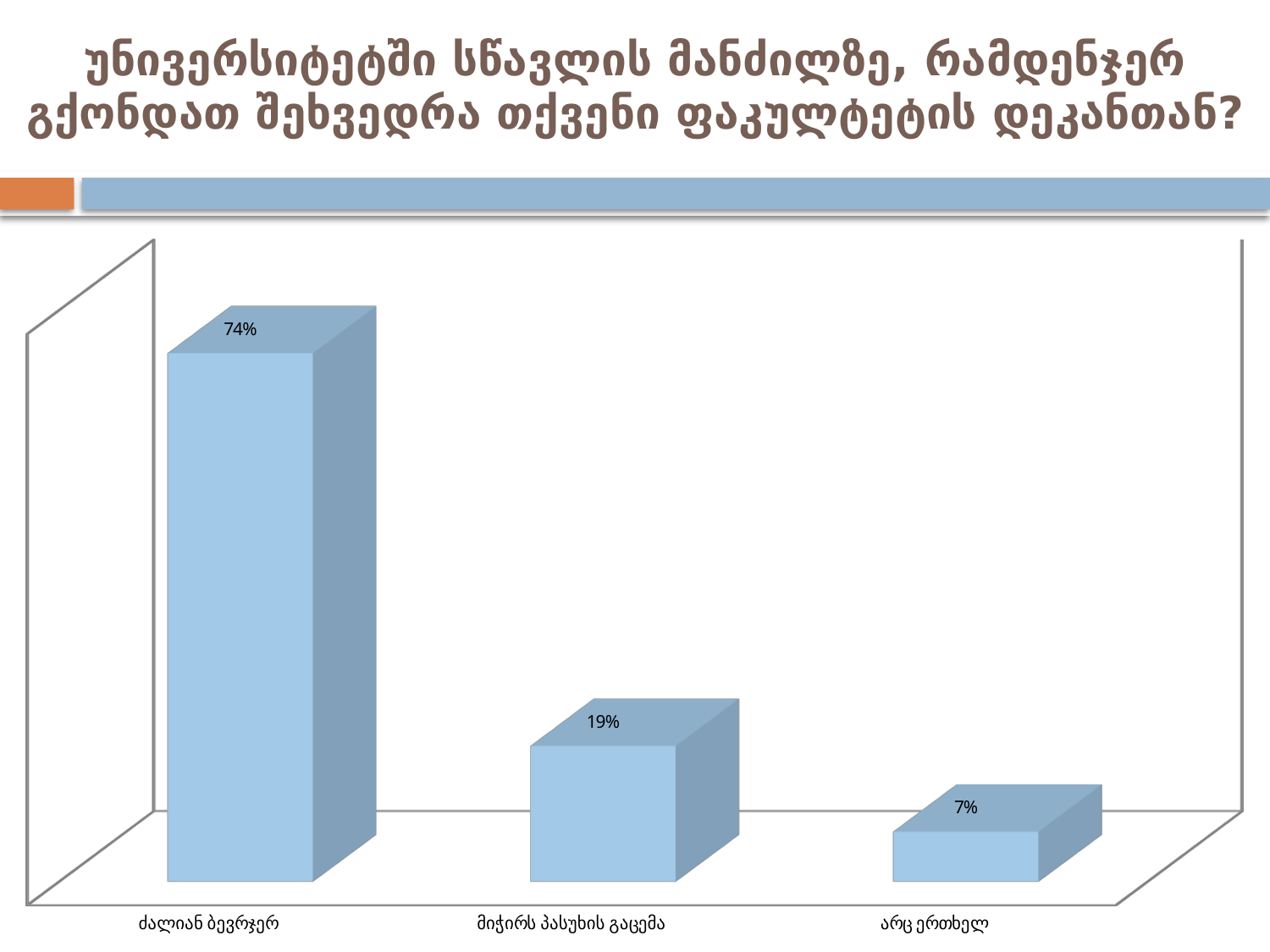
What kind of chart is shown on the slide? bar chart What is the total of the three values shown in the chart? 100% What is the value for მიჭირს პასუხის გაცემა? 19% What is the difference between the values for ძალიან ბევრჯერ and მიჭირს პასუხის გაცემა? 55% Which category has the lowest value? არც ერთხელ Which category has the highest value? ძალიან ბევრჯერ What is the value for არც ერთხელ? 7% Which is larger, the value for მიჭირს პასუხის გაცემა or the value for არც ერთხელ? მიჭირს პასუხის გაცემა What is the difference between the values for მიჭირს პასუხის გაცემა and არც ერთხელ? 12% What is the value for ძალიან ბევრჯერ? 74% How many categories are shown in the chart? 3 Do the values rise or fall from left to right across the categories? fall